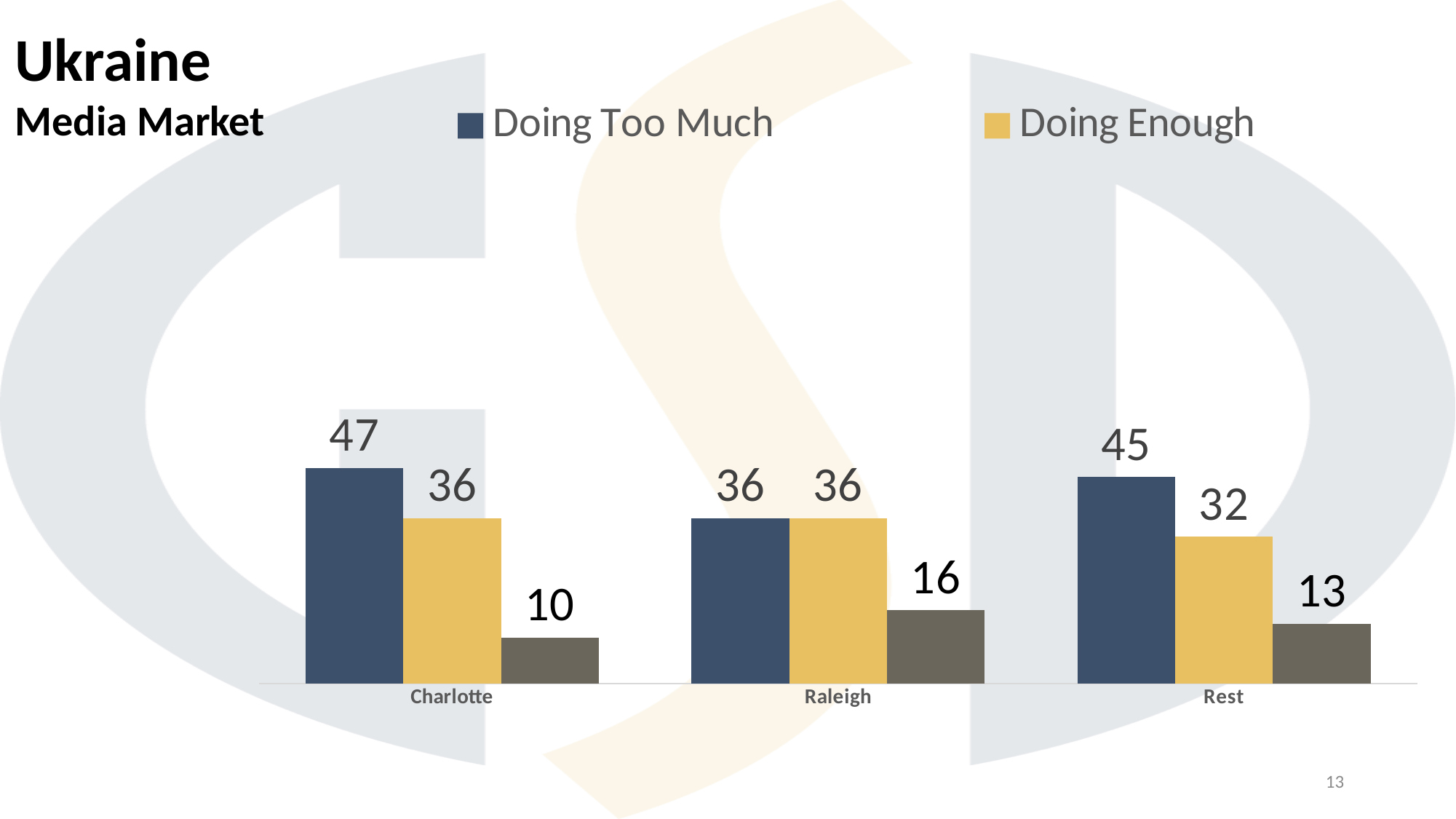
What is the value for Doing Too Much in Raleigh? 36 Which media market has the lowest value for Doing Enough? Rest Which is larger in Charlotte, Doing Too Much or Doing Enough? Doing Too Much What is the value for Doing Too Much in Charlotte? 47 How many media markets are shown on the x axis? 3 What kind of chart is shown on the slide? Bar chart How many series does the legend list? 2 What is the value for Doing Enough in Rest? 32 What is the difference between the Doing Too Much values for Charlotte and Raleigh? 11 Which media market has the highest value for Doing Too Much? Charlotte What is the difference between Doing Too Much and Doing Enough in Rest? 13 What is the value for Doing Enough in Charlotte? 36